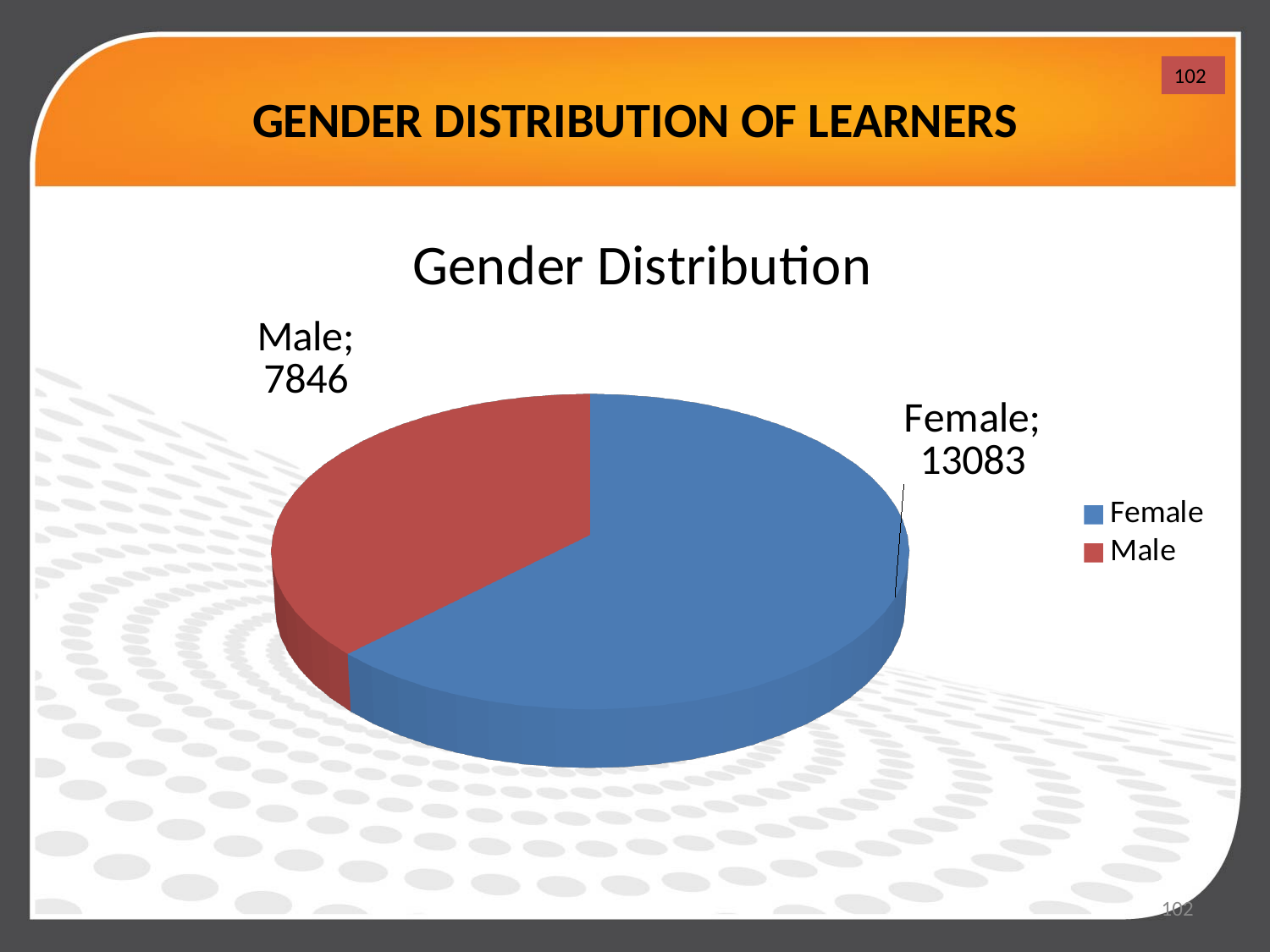
Which category has the smallest slice in the Gender Distribution pie chart? Male What is the value for Male in the Gender Distribution pie chart? 7846 How many categories are shown in the Gender Distribution pie chart? 2 What colour is the Male slice in the Gender Distribution pie chart? Red What is the total of the Female and Male values in the Gender Distribution chart? 20929 What is the difference between the Female and Male values in the Gender Distribution chart? 5237 What is the value for Female in the Gender Distribution pie chart? 13083 What is the title of the chart on the slide? Gender Distribution Which category has the largest slice in the Gender Distribution pie chart? Female What kind of chart is shown on the slide? Pie chart Which is larger in the Gender Distribution chart, the Female value or the Male value? Female